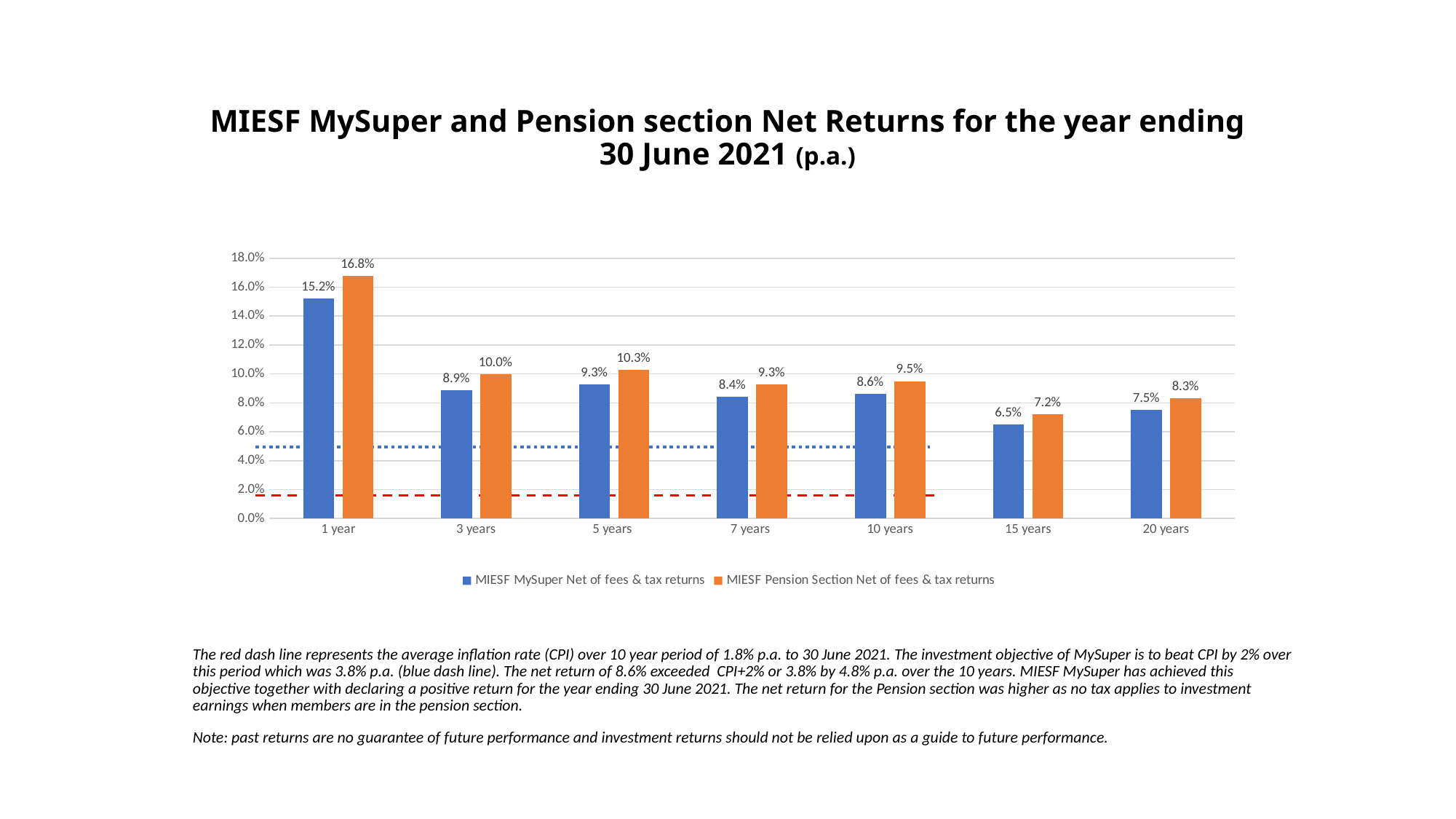
Is the MIESF MySuper return for 15 years greater or less than 8.0%? less How many series does the legend list? 2 What does the red dash line on the chart represent? The average inflation rate (CPI) over 10 years of 1.8% p.a. What is the MIESF MySuper Net of fees & tax return for 1 year? 15.2% Which is larger for 5 years: the MIESF MySuper return or the MIESF Pension Section return? MIESF Pension Section Net of fees & tax returns What kind of chart is shown on the slide? Bar chart What is the MIESF MySuper Net of fees & tax return for 20 years? 7.5% Which period has the highest MIESF Pension Section Net of fees & tax return? 1 year What is the MIESF Pension Section Net of fees & tax return for 10 years? 9.5% What is the difference between the MIESF Pension Section and MIESF MySuper returns for 1 year? 1.6% How many time periods are shown on the x axis? 7 Which period has the lowest MIESF MySuper Net of fees & tax return? 15 years